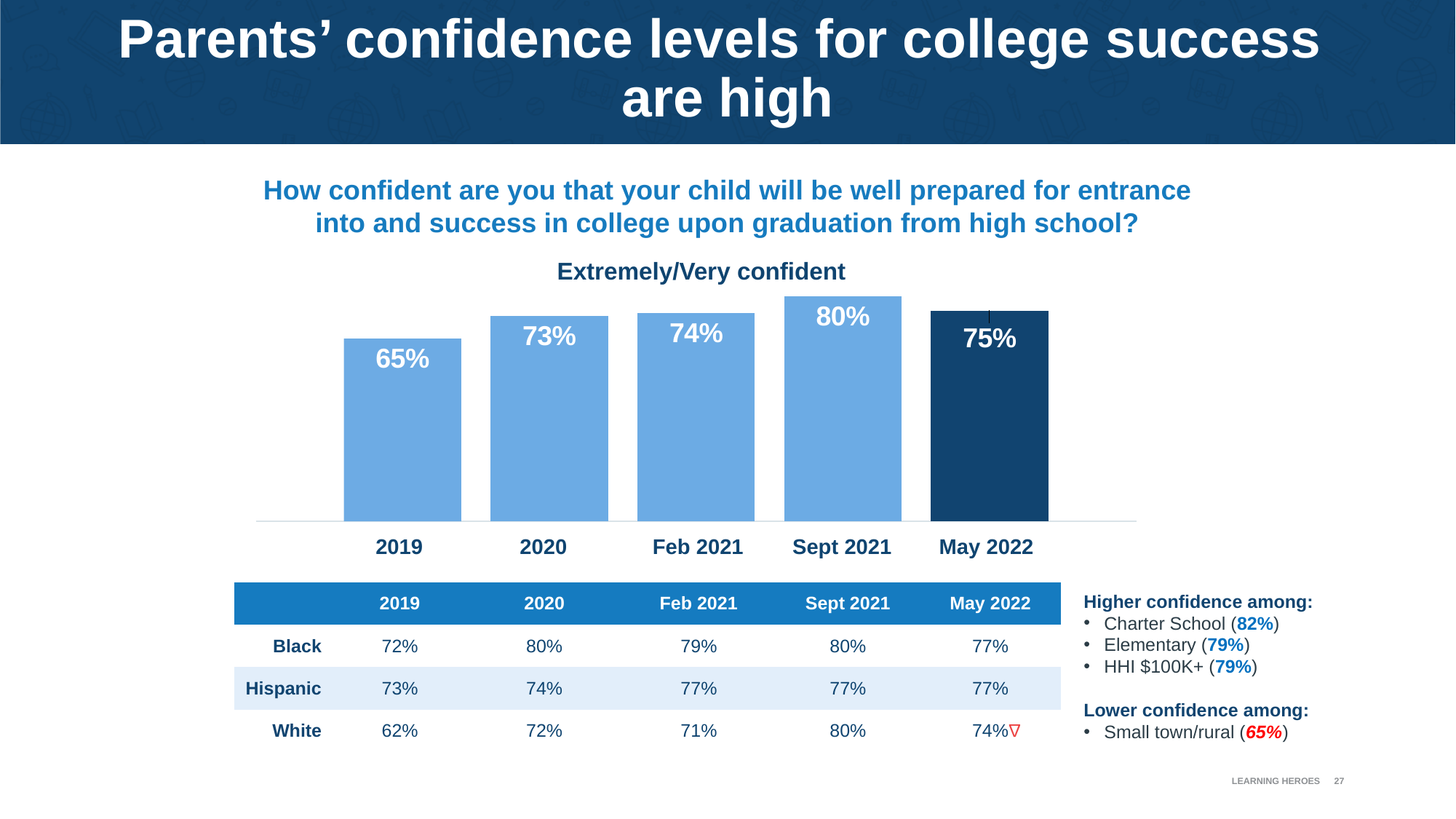
What is the difference between the Sept 2021 value and the May 2022 value? 5 percentage points What type of chart is used to show the extremely/very confident percentages? Bar chart How many periods are shown in the bar chart? 5 What is the value shown for May 2022 in the bar chart? 75% Which bar in the chart is shown in a darker shade of blue than the others? May 2022 Do the values rise or fall from 2019 to Sept 2021? Rise Which is larger, the value for 2020 or the value for Feb 2021? Feb 2021 Which period has the lowest share of extremely/very confident parents? 2019 What percentage of parents were extremely/very confident in 2019? 65% Which period has the highest share of extremely/very confident parents? Sept 2021 What is the difference between the Sept 2021 value and the 2019 value? 15 percentage points What is the value shown for Sept 2021 in the bar chart? 80%